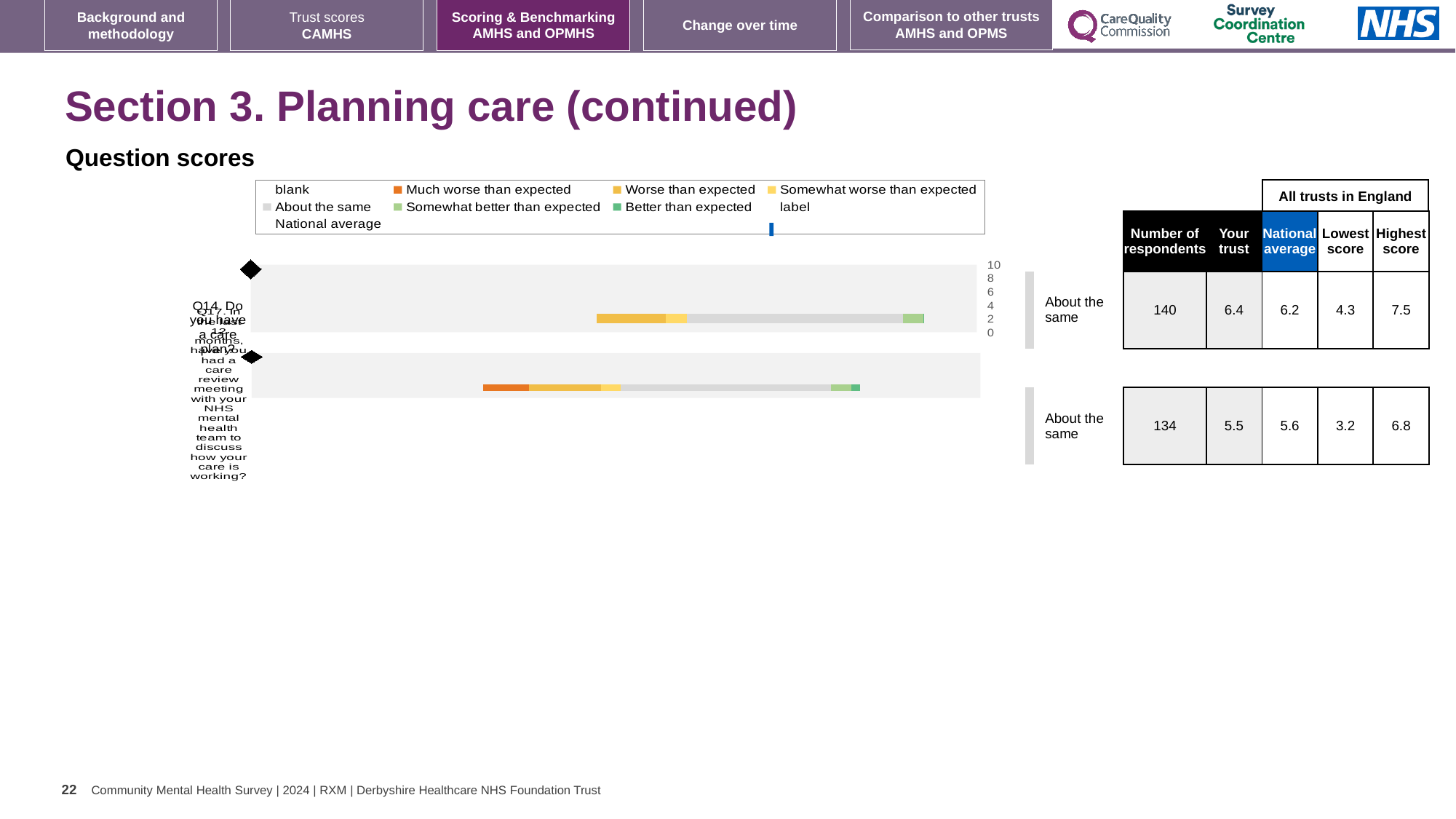
What benchmark category is shown for both Q14 and Q17? About the same What is the national average score for Q17 (care review meeting in the last 12 months)? 5.6 What is the 'Your trust' score for Q14 (Do you have a care plan?)? 6.4 What is the difference between the highest and lowest scores across all trusts in England for Q17? 3.6 What is the lowest score among all trusts in England for Q14? 4.3 Which legend entry is shown in orange in the question scores chart? Much worse than expected What kind of chart is used to show the question scores on this slide? bar chart How many questions (bars) are plotted in the question scores chart? 2 What is the difference between the 'Your trust' score and the national average for Q14? 0.2 What is the highest score among all trusts in England for Q17? 6.8 Which question has the higher 'Your trust' score, Q14 or Q17? Q14 How many respondents answered Q14? 140